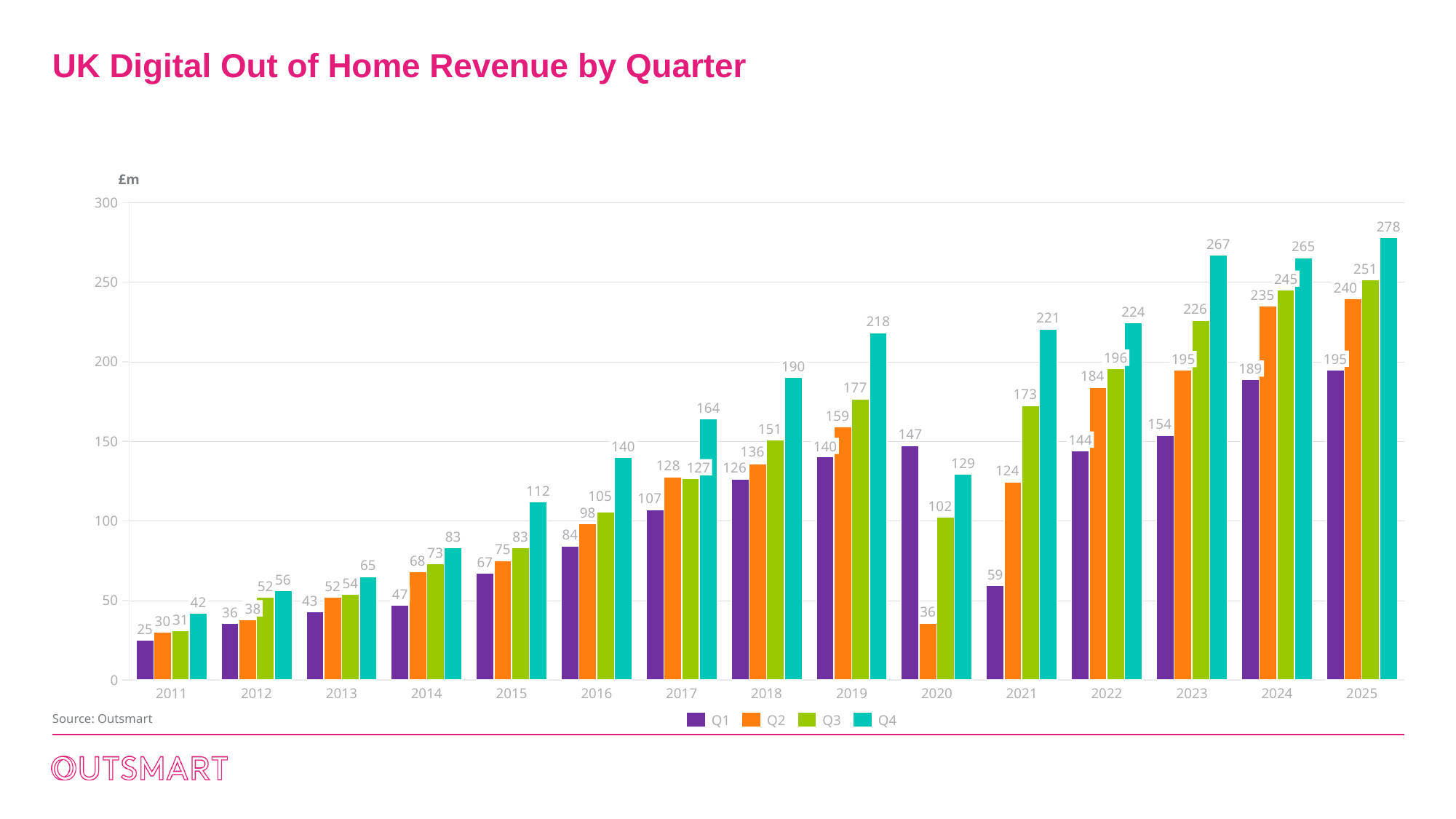
What is the Q4 value for 2025? 278 Which year has the highest Q4 value? 2025 What is the Q2 value for 2020? 36 Is the Q3 value for 2019 greater or less than 150? greater What kind of chart is shown? bar chart How many series does the legend list? 4 What unit is shown on the y axis? £m Which is larger, the Q1 value for 2020 or the Q1 value for 2021? Q1 2020 What is the difference between the Q4 and Q1 values for 2023? 113 Which year has the lowest Q1 value? 2011 What is the Q1 value for 2011? 25 How many years are shown on the x axis? 15